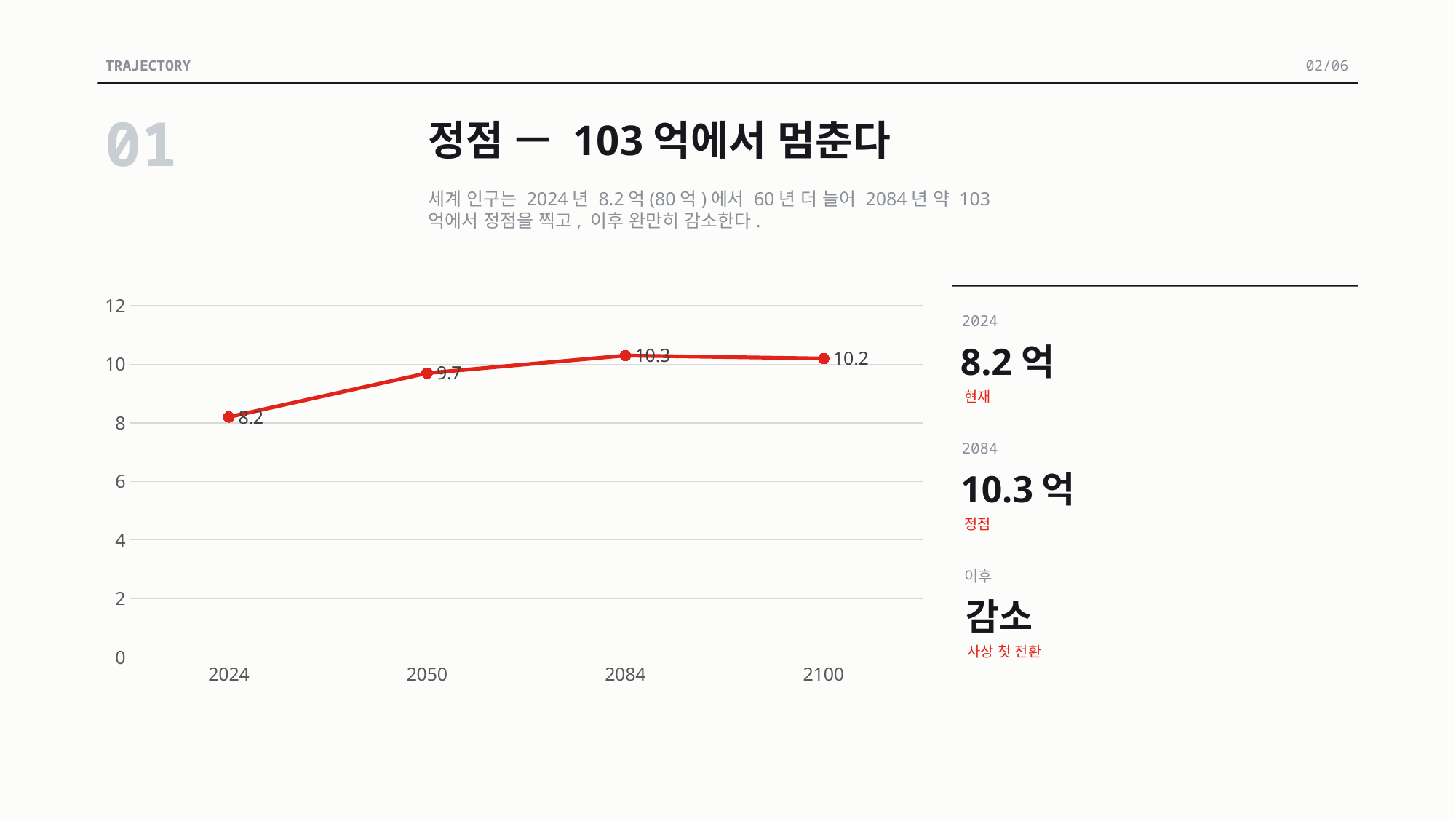
How many data points are plotted on the line? 4 Which year has the highest plotted value? 2084 What is the value plotted for 2084? 10.3 What is the value plotted for 2024? 8.2 What is the value plotted for 2100? 10.2 Which is larger, the value for 2050 or the value for 2100? 2100 What is the difference between the values for 2084 and 2024? 2.1 What is the value plotted for 2050? 9.7 Which year has the lowest plotted value? 2024 What kind of chart is shown on the slide? line chart Is the value for 2050 greater or less than 10? less Does the line rise or fall between 2024 and 2084? rise